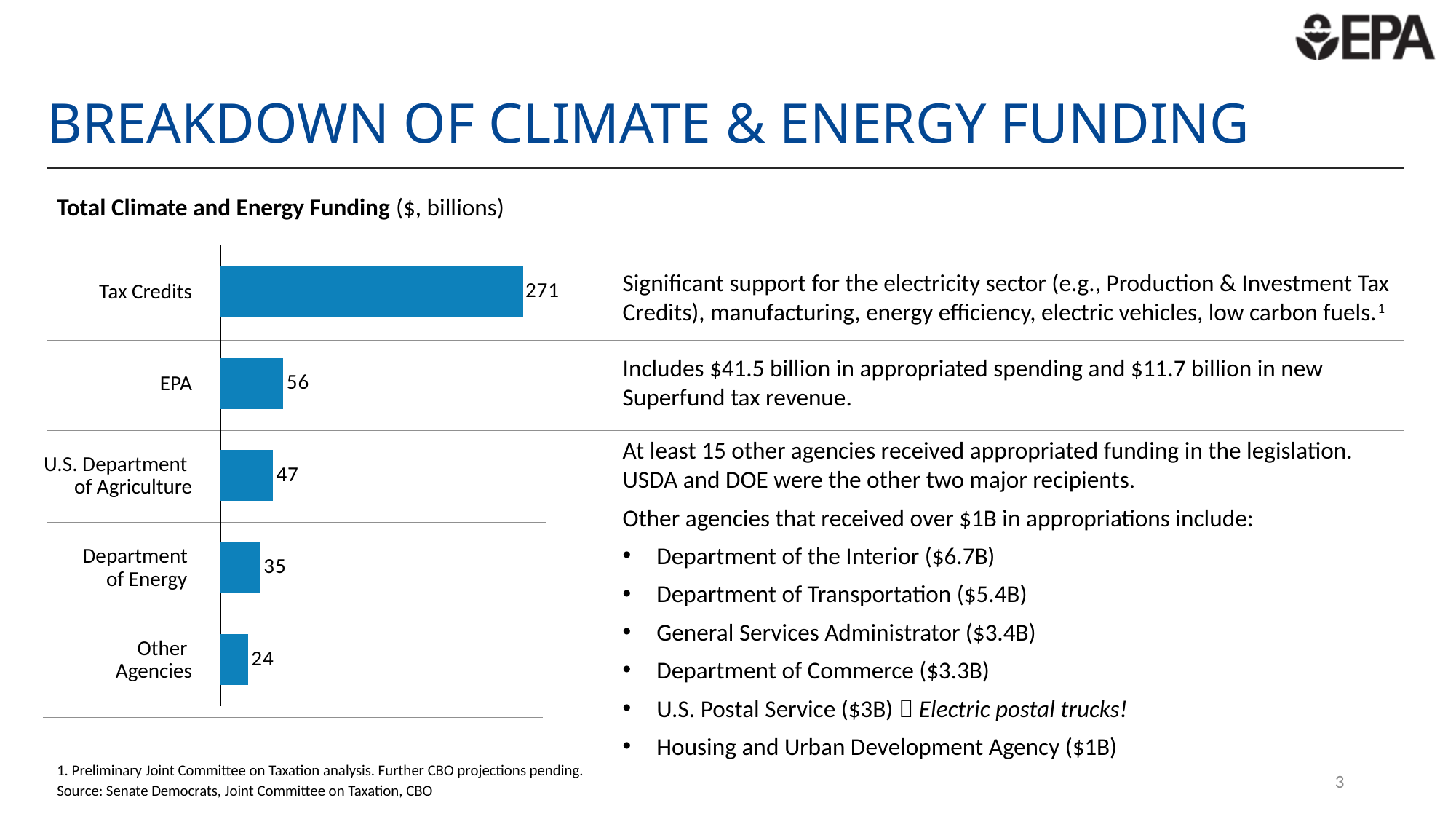
What is the value for Other Agencies in the chart? 24 What is the difference between the values for Tax Credits and EPA? 215 Which category has the lowest value in the Total Climate and Energy Funding chart? Other Agencies What kind of chart is shown on the slide? Bar chart Which category has the highest value in the Total Climate and Energy Funding chart? Tax Credits What is the value for Tax Credits in the Total Climate and Energy Funding chart? 271 How many categories are shown in the Total Climate and Energy Funding chart? 5 Which is larger, the value for U.S. Department of Agriculture or the value for Department of Energy? U.S. Department of Agriculture What is the value for EPA in the Total Climate and Energy Funding chart? 56 What is the value for Department of Energy in the chart? 35 What is the value for U.S. Department of Agriculture in the chart? 47 What is the difference between the values for EPA and Department of Energy? 21